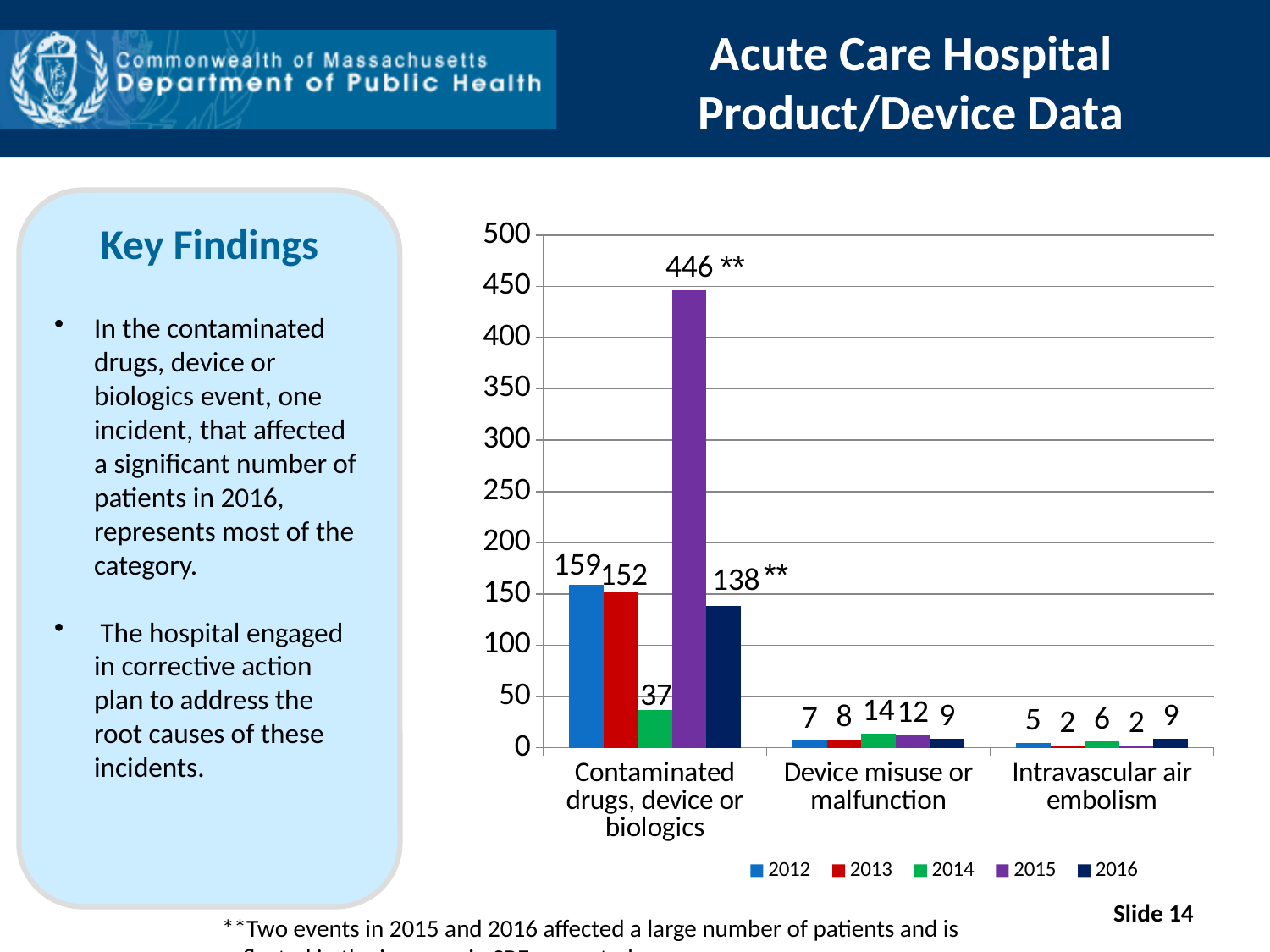
What is the value for 2016 in the Device misuse or malfunction category? 9 What is the value for 2015 in the Contaminated drugs, device or biologics category? 446 What kind of chart is shown on the slide? bar chart Is the 2015 value for Contaminated drugs, device or biologics greater or less than 400? greater Which year has the highest value in the Contaminated drugs, device or biologics category? 2015 What is the value for 2012 in the Intravascular air embolism category? 5 Which is larger in the Intravascular air embolism category, the 2014 value or the 2016 value? 2016 How many series does the legend list? 5 Which year has the lowest value in the Device misuse or malfunction category? 2012 What is the value for 2014 in the Contaminated drugs, device or biologics category? 37 What is the difference between the 2012 and 2016 values in the Contaminated drugs, device or biologics category? 21 How many categories are shown on the x axis? 3